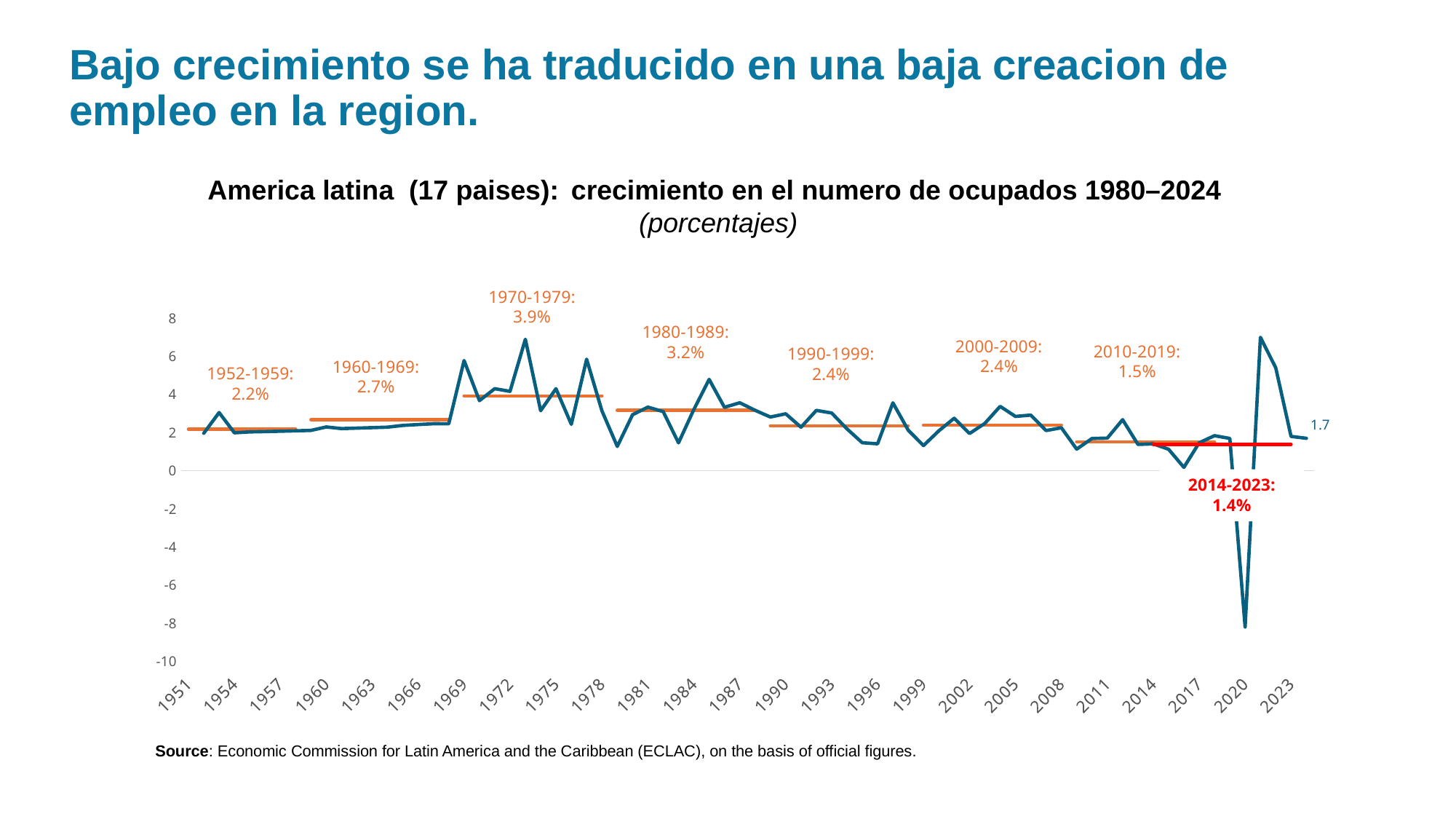
What is the difference between the average growth for 1970-1979 and for 2010-2019? 2.4 percentage points How many period averages are annotated on the chart? 8 What is the average growth shown for the period 2010-2019? 1.5% What value is labelled at the last point of the line, at the right end of the chart? 1.7 What kind of chart is shown on the slide? line chart Which annotated period has the lowest average growth? 2014-2023 Is the value of the line in 2020 greater or less than -6? less What is the average growth shown for the period 1980-1989? 3.2% What is the average growth shown for the period 2014-2023? 1.4% Which period has the larger average growth, 1952-1959 or 1960-1969? 1960-1969 What is the average growth shown for the period 1970-1979? 3.9% Which annotated period has the highest average growth? 1970-1979